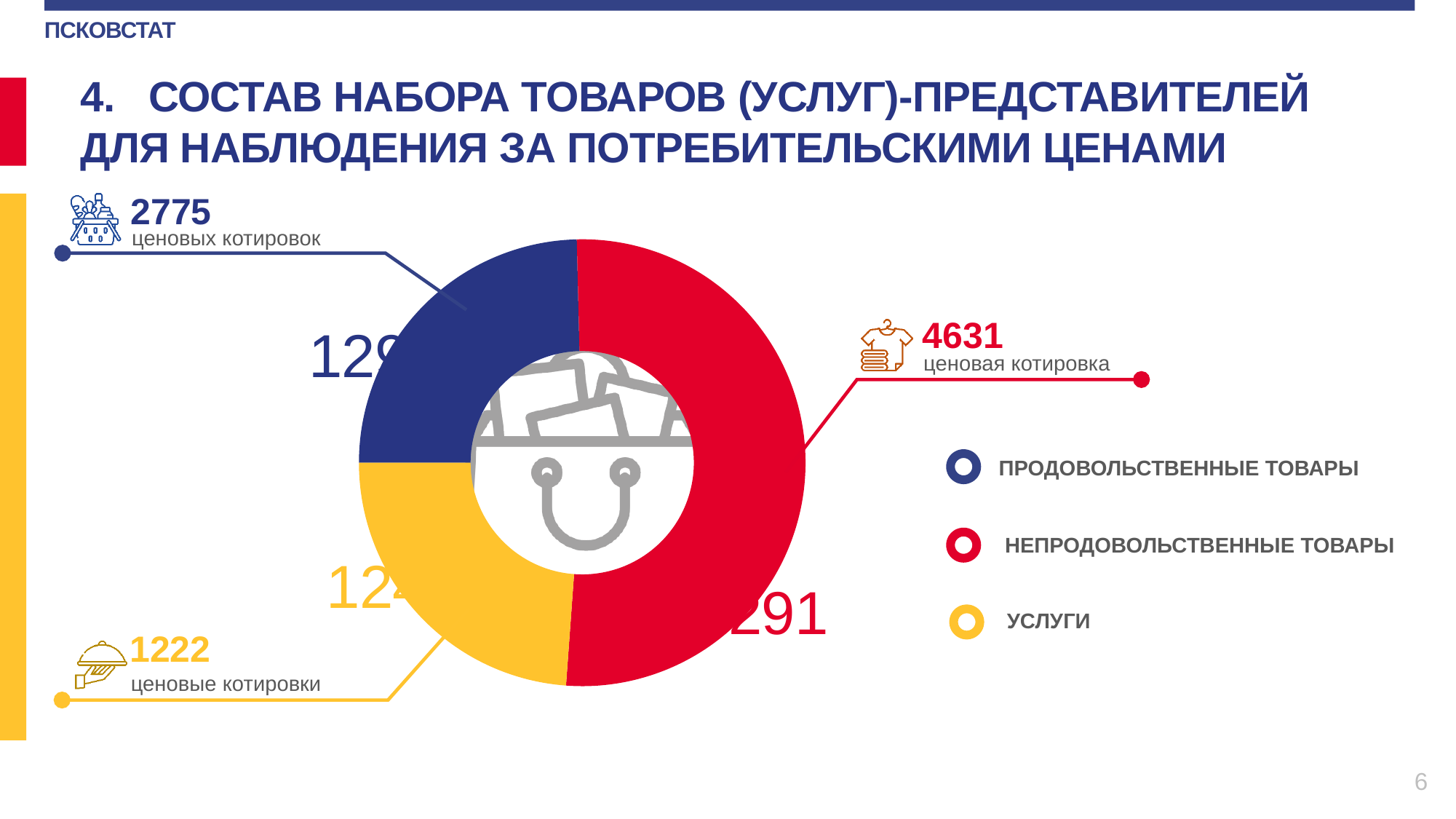
Which segment is larger: НЕПРОДОВОЛЬСТВЕННЫЕ ТОВАРЫ or УСЛУГИ? НЕПРОДОВОЛЬСТВЕННЫЕ ТОВАРЫ How many price quotations (ценовые котировки) are shown for УСЛУГИ? 1222 How many price quotations (ценовых котировок) are shown for ПРОДОВОЛЬСТВЕННЫЕ ТОВАРЫ? 2775 What is the difference between the number of price quotations for ПРОДОВОЛЬСТВЕННЫЕ ТОВАРЫ (2775) and УСЛУГИ (1222)? 1553 What is the difference between the number of price quotations for НЕПРОДОВОЛЬСТВЕННЫЕ ТОВАРЫ (4631) and ПРОДОВОЛЬСТВЕННЫЕ ТОВАРЫ (2775)? 1856 How many price quotations (ценовая котировка) are shown for НЕПРОДОВОЛЬСТВЕННЫЕ ТОВАРЫ? 4631 How many categories does the legend of the chart list? 3 Which segment is larger: НЕПРОДОВОЛЬСТВЕННЫЕ ТОВАРЫ or ПРОДОВОЛЬСТВЕННЫЕ ТОВАРЫ? НЕПРОДОВОЛЬСТВЕННЫЕ ТОВАРЫ Which colour represents ПРОДОВОЛЬСТВЕННЫЕ ТОВАРЫ in the chart? blue Which category has the largest segment in the chart? НЕПРОДОВОЛЬСТВЕННЫЕ ТОВАРЫ Which group has more price quotations: НЕПРОДОВОЛЬСТВЕННЫЕ ТОВАРЫ or ПРОДОВОЛЬСТВЕННЫЕ ТОВАРЫ? НЕПРОДОВОЛЬСТВЕННЫЕ ТОВАРЫ What kind of chart is shown on the slide? pie chart (donut)